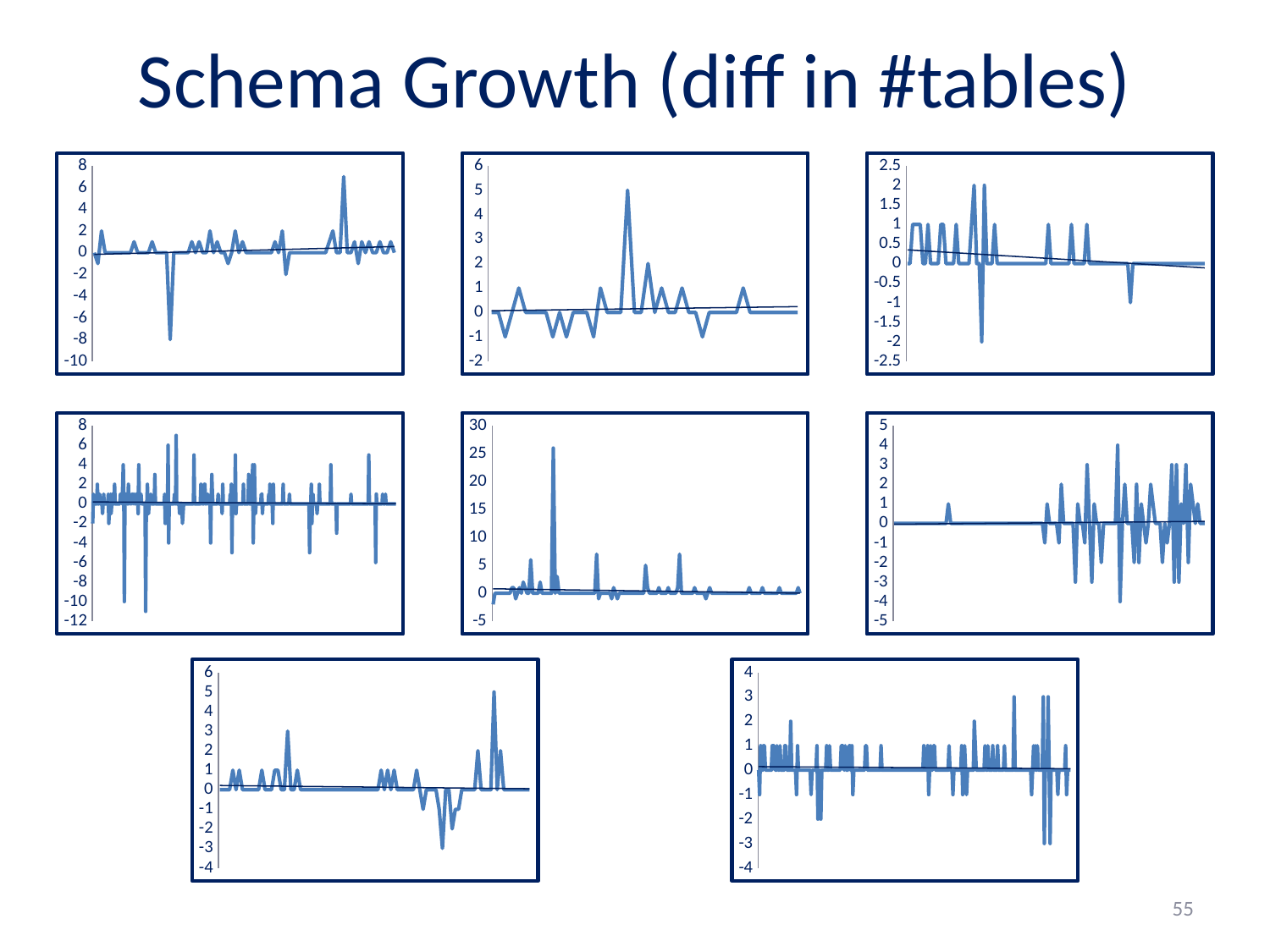
In the right chart of the second row, is the highest peak greater or less than 3? greater In the top-right chart, is the lowest dip greater or less than -1.5? less In the top-middle chart, is the highest peak greater or less than 4? greater How many charts are shown on the slide? 8 What kind of chart is the top-left chart on the slide? line chart What is the title of the slide containing the charts? Schema Growth (diff in #tables)